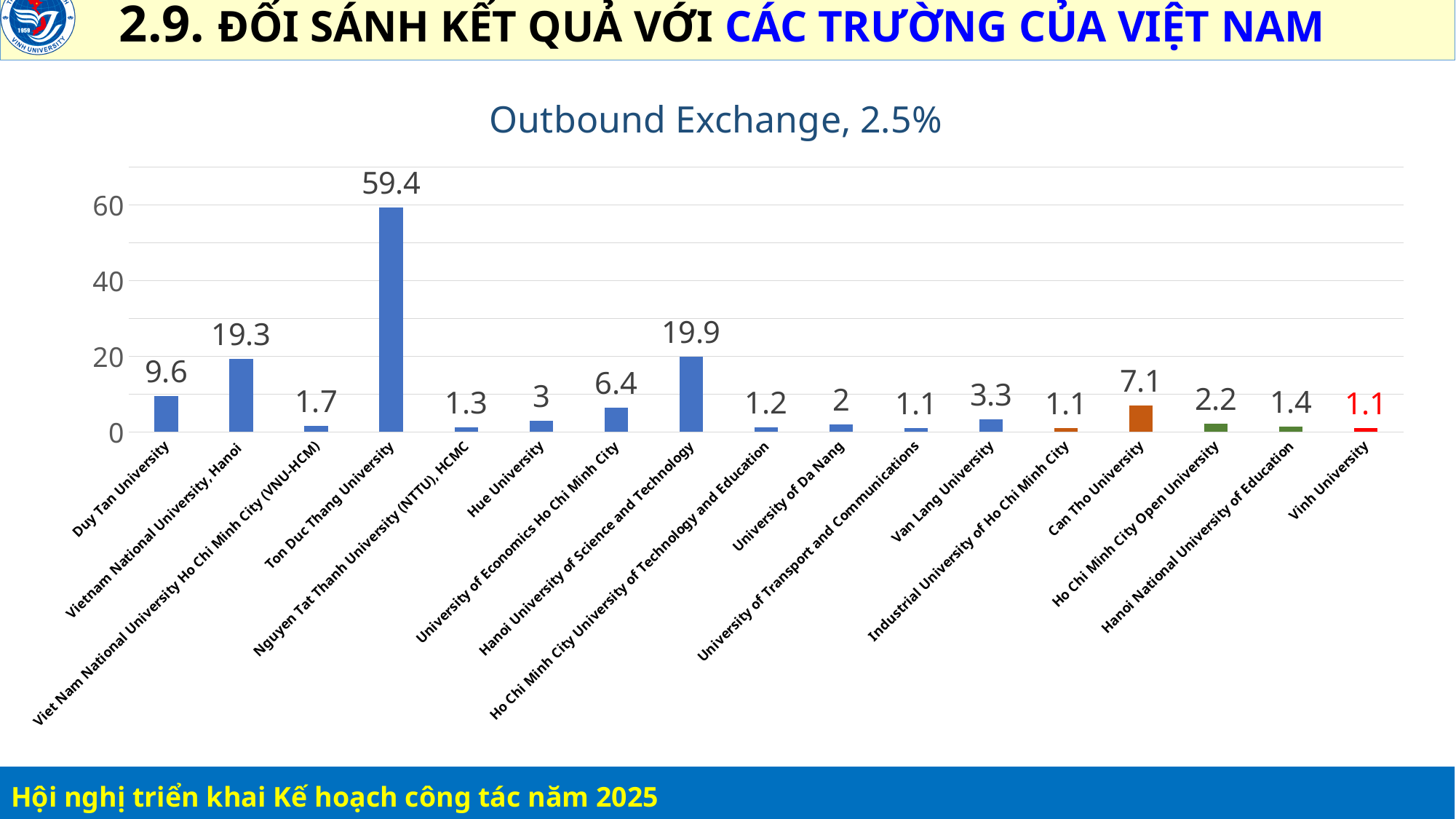
What is the value for Vinh University? 1.1 What is the difference between the values for Ton Duc Thang University and Hanoi University of Science and Technology? 39.5 What is the value for Ton Duc Thang University? 59.4 What is the title of the chart? Outbound Exchange, 2.5% Which university has the highest value in the chart? Ton Duc Thang University Is the value for Ton Duc Thang University greater or less than 40? greater How many universities are shown in the chart? 17 What kind of chart is shown on the slide? bar chart What is the value for Hanoi University of Science and Technology? 19.9 Which is larger, the value for Hanoi University of Science and Technology or the value for Vietnam National University, Hanoi? Hanoi University of Science and Technology What is the difference between the values for Duy Tan University and Can Tho University? 2.5 What is the value for Can Tho University? 7.1